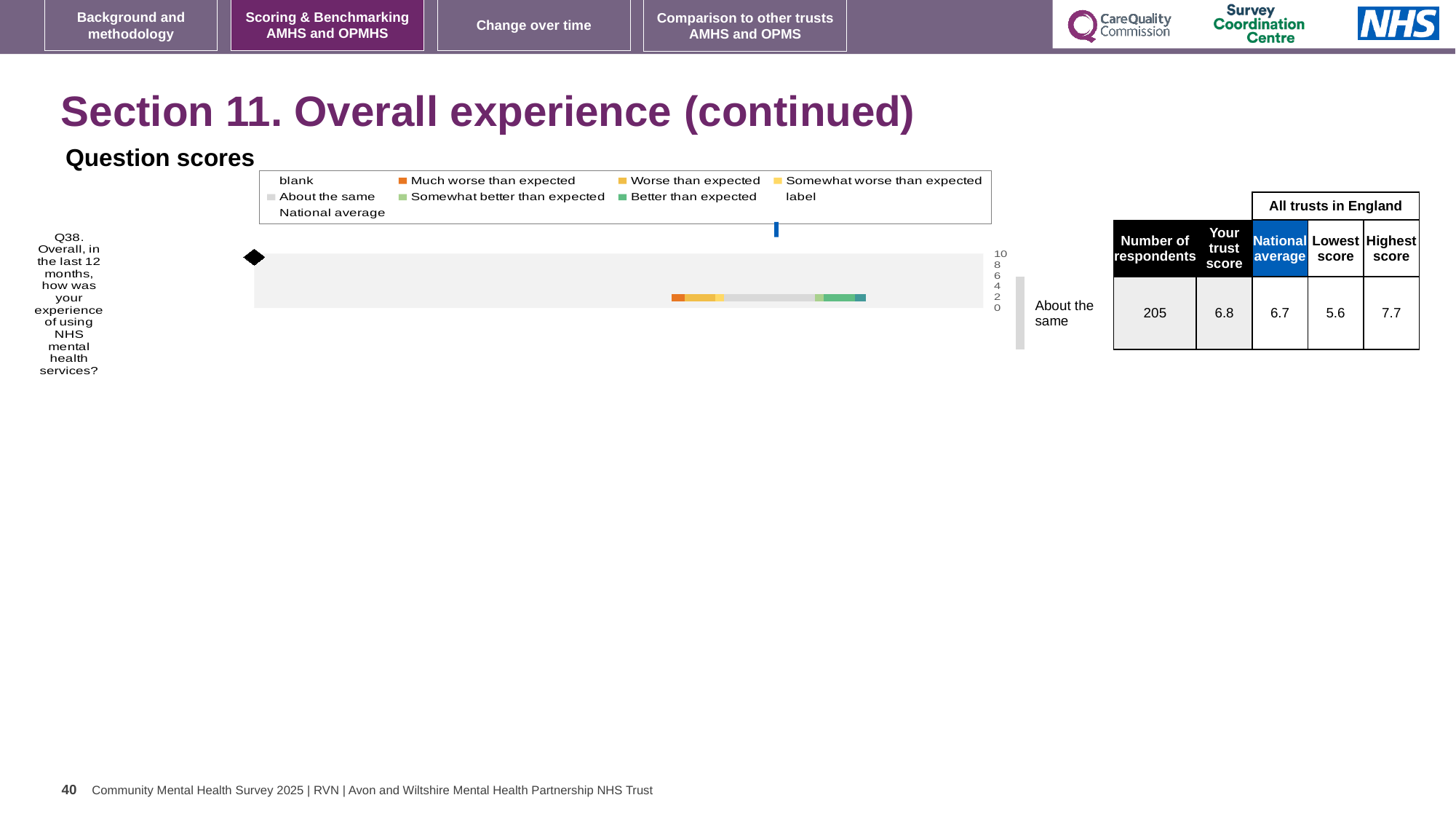
For Q38, what is the difference between Your trust score and the National average? 0.1 What is 'Your trust score' for Q38 in the table beside the Question scores chart? 6.8 For Q38, what is the difference between the Highest score and the Lowest score among all trusts in England? 2.1 In the Question scores chart legend, what colour represents 'Much worse than expected'? orange Which benchmark category is shown next to the Q38 bar in the Question scores chart? About the same How many respondents answered Q38 according to the table beside the chart? 205 For Q38, which is larger: Your trust score or the National average? Your trust score What is the National average score for Q38 shown in the table beside the chart? 6.7 How many survey questions are plotted in the Question scores chart? 1 What is the Lowest score among all trusts in England for Q38? 5.6 What kind of chart is used to show the Q38 question score? bar chart What is the Highest score among all trusts in England for Q38? 7.7